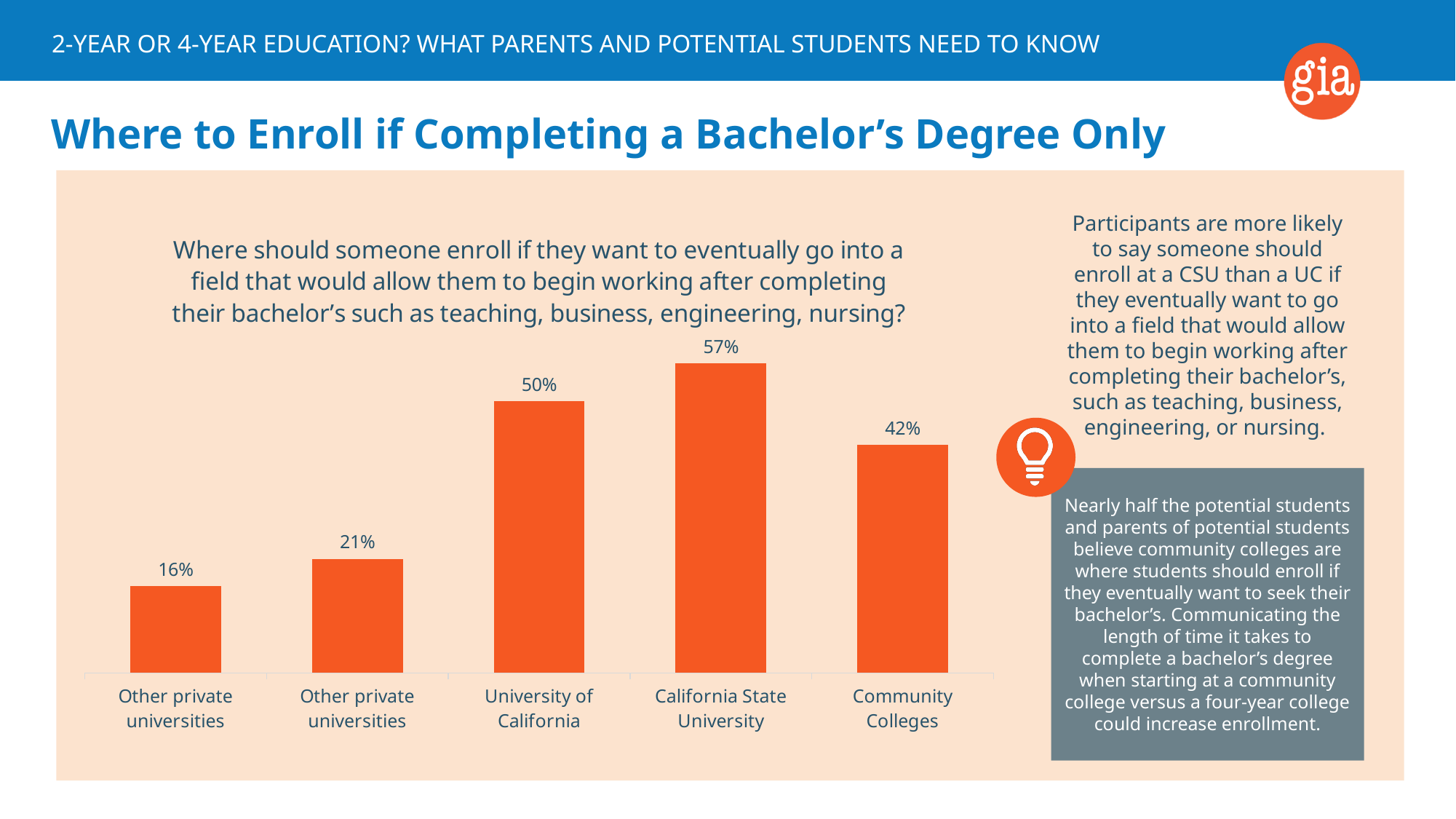
Which is larger, the value for Community Colleges or the value for the University of California? University of California What percentage of participants said someone should enroll at the University of California? 50% What is the lowest value shown in the chart? 16% What percentage of participants said someone should enroll at California State University? 57% What is the difference between the values for the University of California and Community Colleges? 8% What colour are the bars in the chart? Orange How many bars are shown in the chart? 5 What type of chart is shown on the slide? Bar chart What percentage of participants said someone should enroll at Community Colleges? 42% Which category has the highest value in the chart? California State University What is the title of the slide? Where to Enroll if Completing a Bachelor's Degree Only What is the difference between the values for California State University and the University of California? 7%